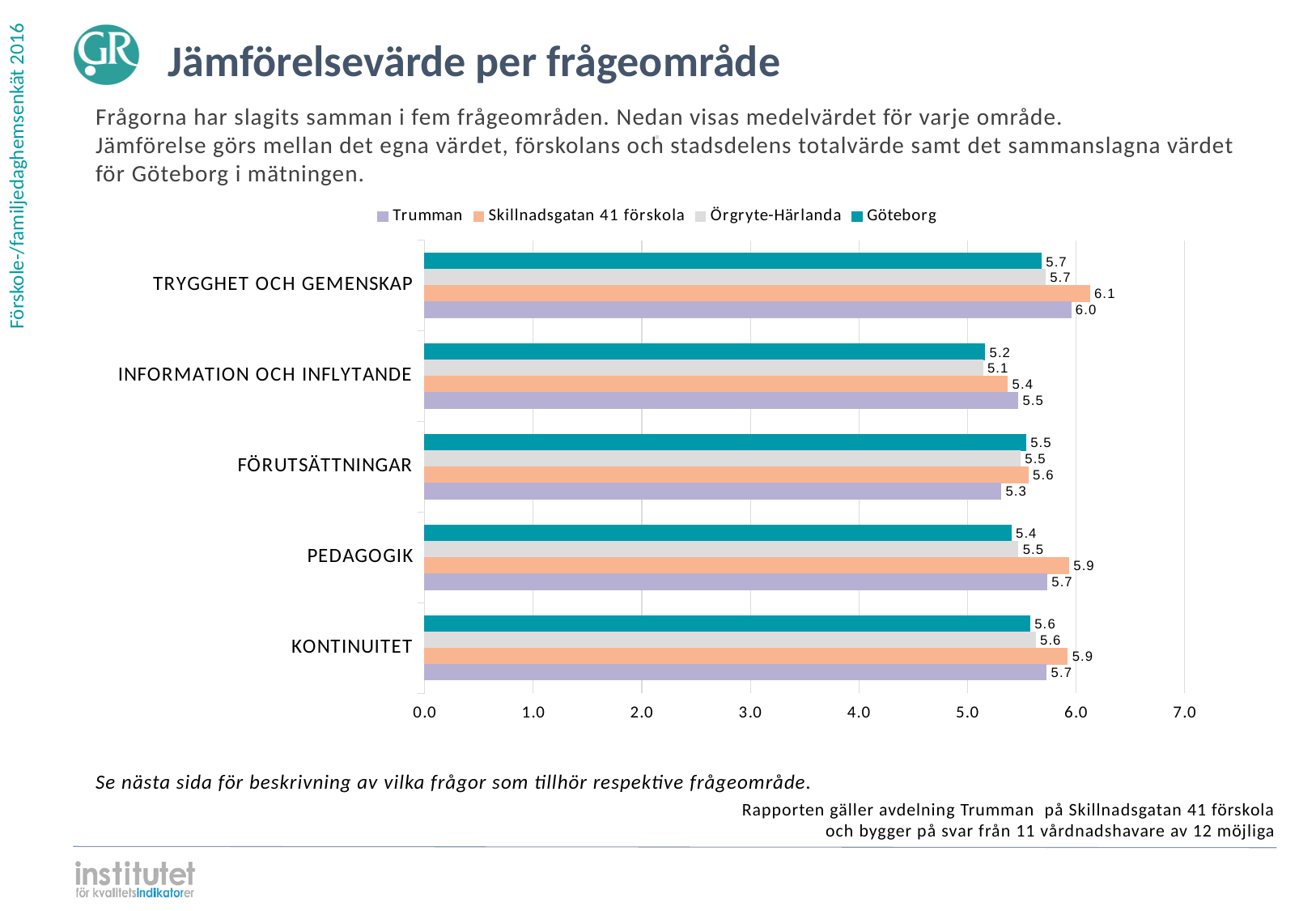
What is the value for Skillnadsgatan 41 förskola in PEDAGOGIK? 5.9 What is the value for Göteborg in INFORMATION OCH INFLYTANDE? 5.2 In which category does Trumman have its lowest value? FÖRUTSÄTTNINGAR Which is larger in FÖRUTSÄTTNINGAR: Trumman or Skillnadsgatan 41 förskola? Skillnadsgatan 41 förskola What is the difference between Skillnadsgatan 41 förskola and Göteborg in PEDAGOGIK? 0.5 What kind of chart is shown on the slide? Bar chart In which category does Skillnadsgatan 41 förskola have its highest value? TRYGGHET OCH GEMENSKAP How many question areas (categories) are shown on the chart? 5 Which series is shown in teal in the legend? Göteborg What is the value for Örgryte-Härlanda in KONTINUITET? 5.6 What is the value for Trumman in TRYGGHET OCH GEMENSKAP? 6.0 How many series does the legend list? 4